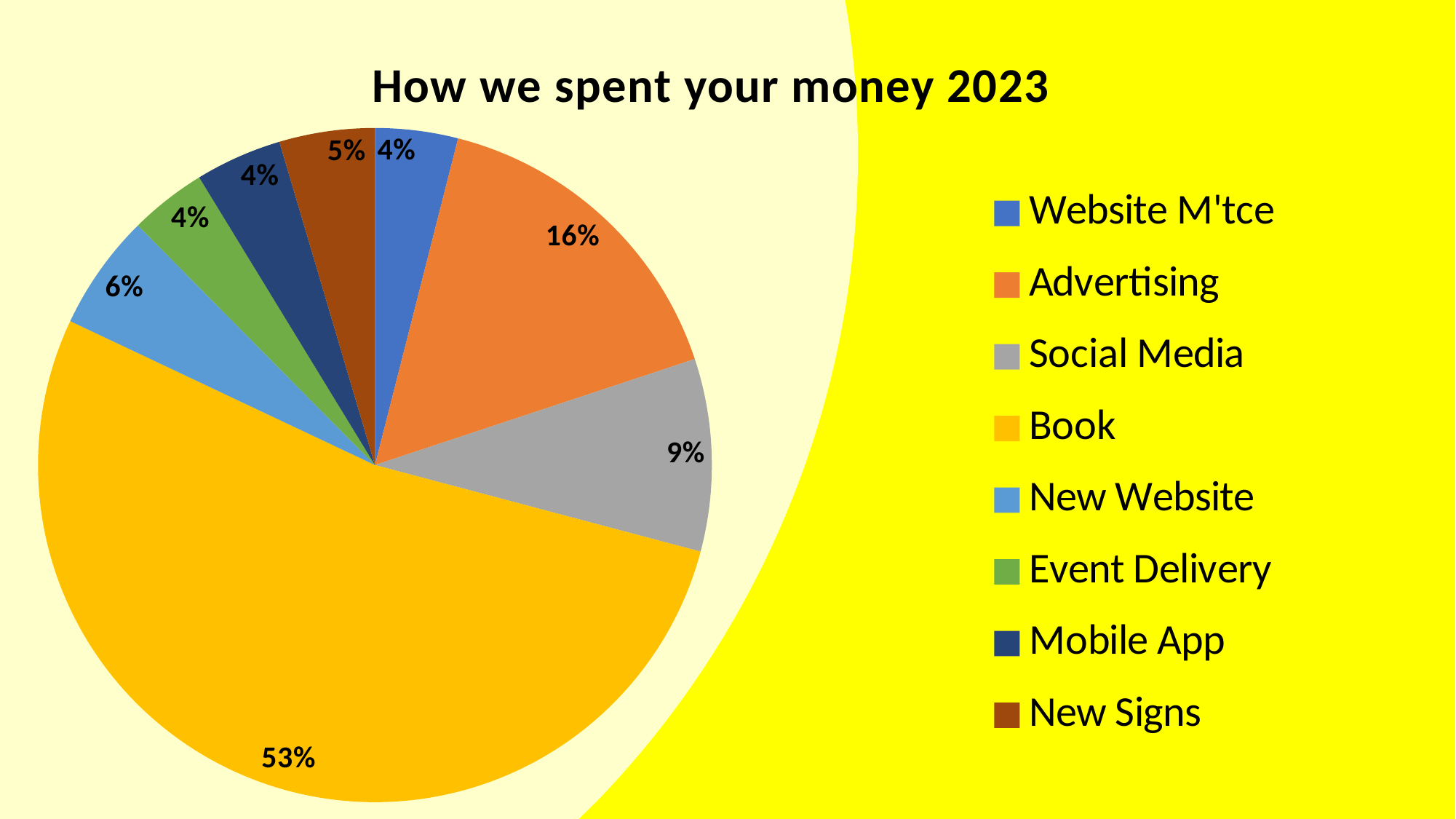
How many categories does the legend list? 8 What is the title of the chart? How we spent your money 2023 What share of spending went to Book? 53% Which received a larger share of spending, New Website or New Signs? New Website What percentage of spending went to New Website? 6% What percentage of spending went to New Signs? 5% What percentage of spending went to Social Media? 9% What is the difference in percentage points between Advertising and Social Media? 7 Which category accounts for the largest share of spending? Book What colour is the Book slice in the pie chart? Yellow What type of chart is shown on the slide? Pie chart What percentage of spending went to Advertising? 16%